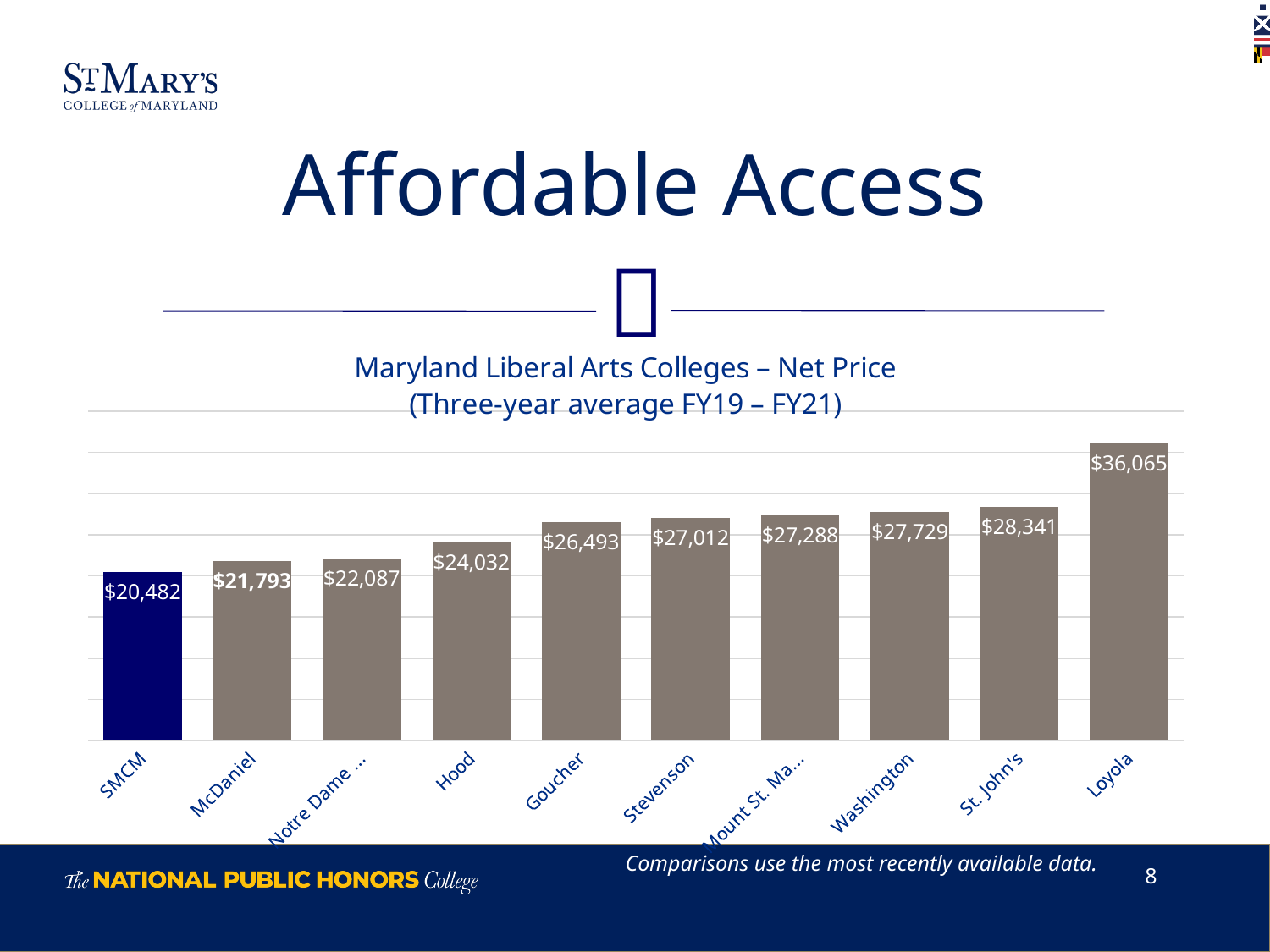
Which has a higher net price, Washington or Stevenson? Washington What is the net price shown for Loyola? $36,065 What is the net price shown for SMCM? $20,482 Which college has the highest net price in the chart? Loyola What is the net price shown for Hood? $24,032 What kind of chart is shown on the slide? Bar chart How many colleges are shown in the chart? 10 What is the net price shown for Goucher? $26,493 What is the difference between the net price for Loyola and the net price for SMCM? $15,583 What is the net price shown for St. John's? $28,341 Which college has the lowest net price in the chart? SMCM What is the difference between the net price for McDaniel and the net price for SMCM? $1,311